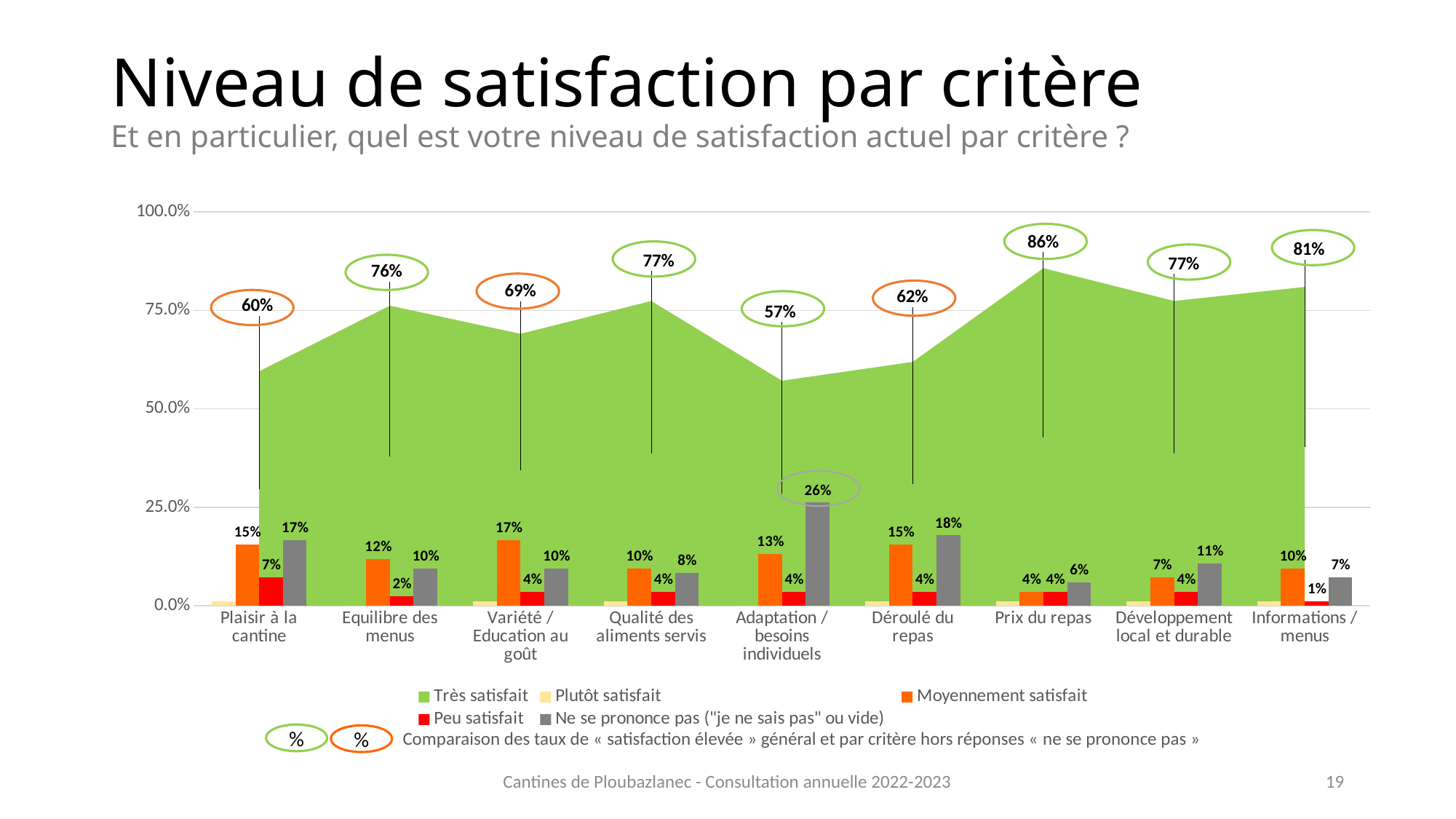
Which has a larger Moyennement satisfait value: Variété / Education au goût or Qualité des aliments servis? Variété / Education au goût What is the value of Moyennement satisfait for Plaisir à la cantine? 15% Which category has the lowest Moyennement satisfait value? Prix du repas Which category has the highest Peu satisfait value? Plaisir à la cantine Is the Très satisfait value for Prix du repas greater or less than 75.0%? greater What is the difference between the Ne se prononce pas values for Déroulé du repas and Equilibre des menus? 8 percentage points What is the value of Peu satisfait for Informations / menus? 1% What is the value of Ne se prononce pas for Adaptation / besoins individuels? 26% How many series does the legend list? 5 How many categories are shown on the x axis? 9 Is the Très satisfait value for Adaptation / besoins individuels greater or less than 75.0%? less Which category has the highest Ne se prononce pas value? Adaptation / besoins individuels